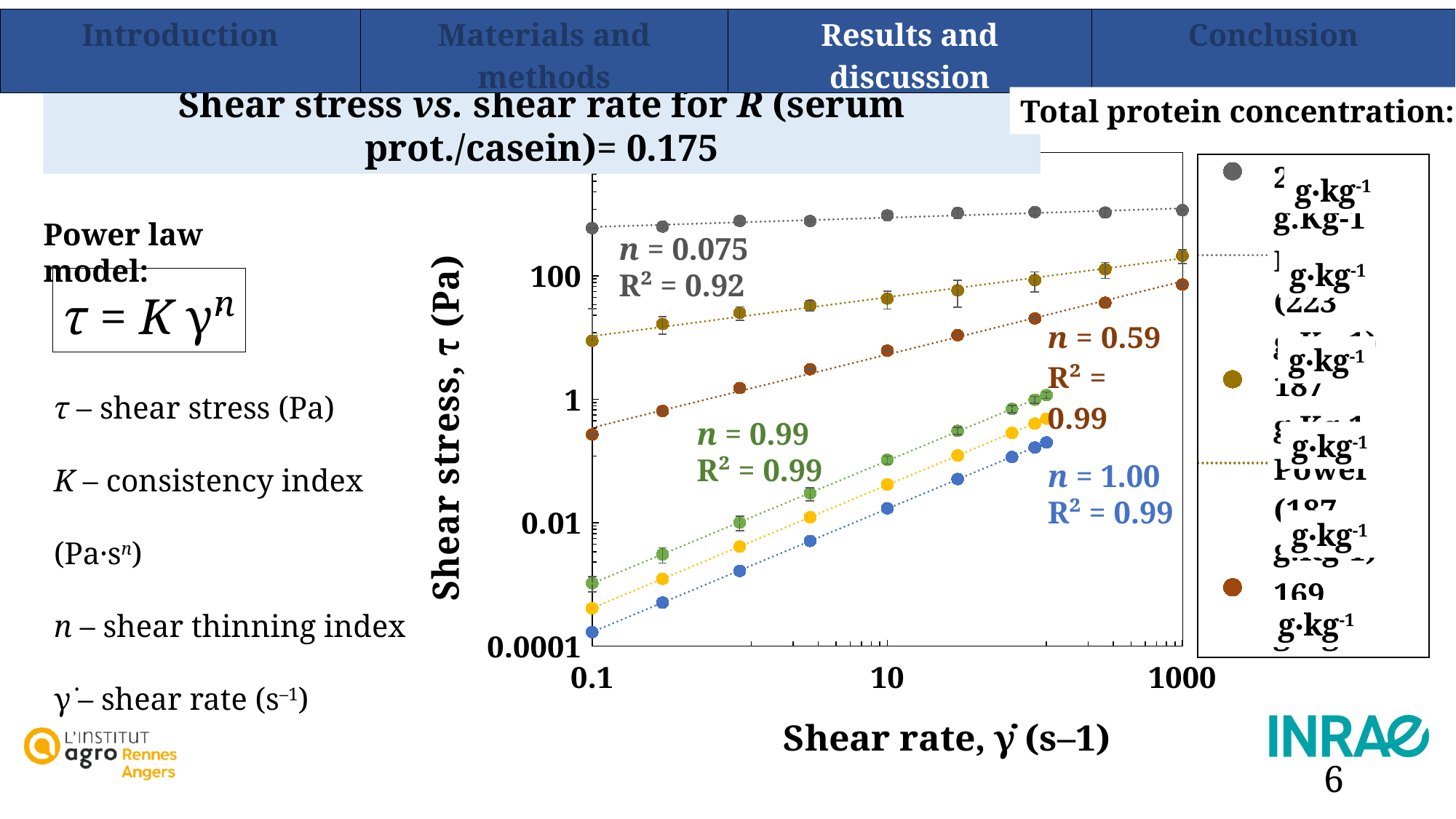
What is the title of the chart? Shear stress vs. shear rate for R (serum prot./casein)= 0.175 What is the value of n annotated for the blue (bottom) series? 1.00 Do the shear stress values rise or fall as shear rate increases along the x axis? Rise What kind of chart is shown on the slide? Scatter chart What R² value is annotated for the grey (top) series? 0.92 What is the value of n annotated for the grey (top) series? 0.075 Is the shear stress of the brown series at a shear rate of 0.1 greater or less than 1 Pa? less Which annotated series has the lowest shear thinning index n? The grey series (n = 0.075) What is the label of the y axis of the chart? Shear stress, τ (Pa) Which plotted series has the highest shear stress values across the shear rate range? The grey series Is the shear stress of the grey series at a shear rate of 0.1 greater or less than 100 Pa? greater What is the value of n annotated for the brown series? 0.59